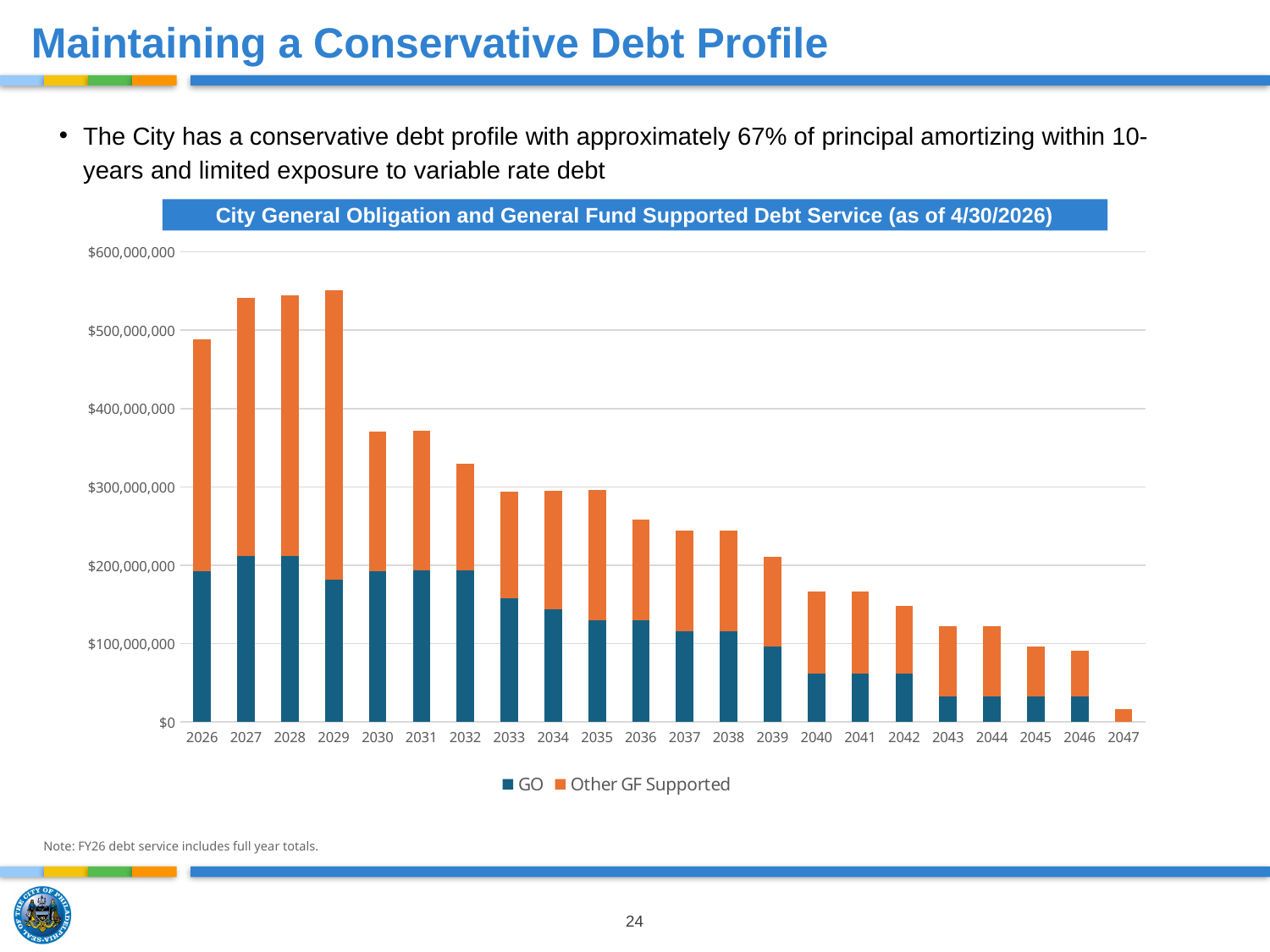
How many years are shown along the x axis of the chart? 22 Is the total debt service for 2030 greater or less than $400,000,000? less Which year has the larger total debt service, 2026 or 2030? 2026 Is the total debt service for 2043 greater or less than $200,000,000? less Which series is shown in orange in the chart? Other GF Supported What is the title of the chart? City General Obligation and General Fund Supported Debt Service (as of 4/30/2026) Which year has the lowest total debt service in the chart? 2047 What kind of chart is shown on the slide? Stacked bar chart Do the total debt service values generally rise or fall from 2029 to 2047? fall Is the total debt service for 2026 greater or less than $400,000,000? greater How many series does the chart's legend list? 2